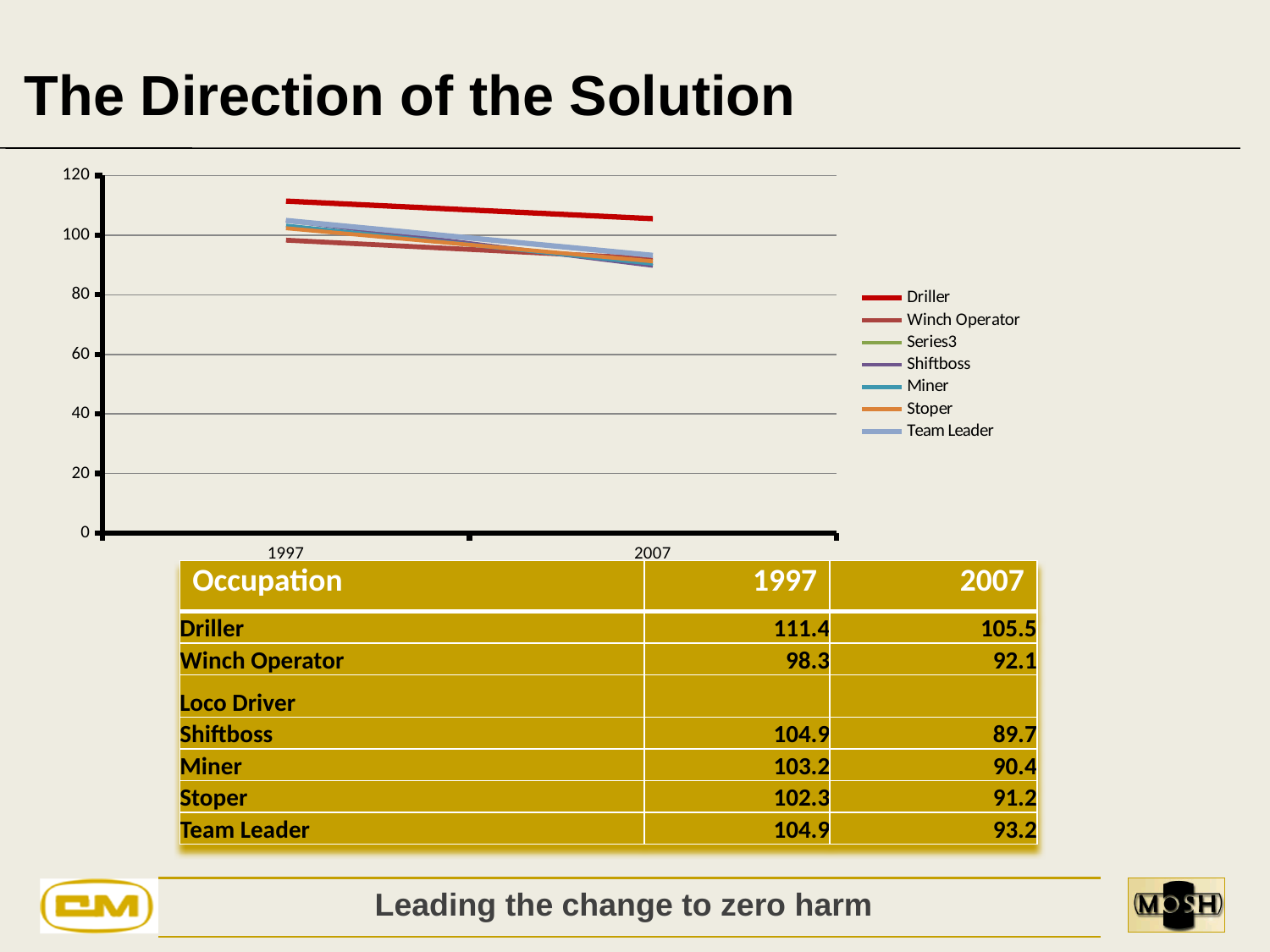
Which occupation has the lowest value in 1997? Winch Operator Does the Driller line rise or fall from 1997 to 2007? fall Which occupation has the highest value in 2007? Driller Is the value for Driller in 2007 greater or less than 100? greater What kind of chart is shown on the slide? line chart What is the value for Stoper in 1997? 102.3 What is the value for Shiftboss in 2007? 89.7 Which is larger, the 2007 value for Team Leader or the 2007 value for Miner? Team Leader How many points are there along the x axis of the chart? 2 What is the value for Driller in 1997? 111.4 How many series does the chart legend list? 7 What is the difference between the Driller values in 1997 and 2007? 5.9